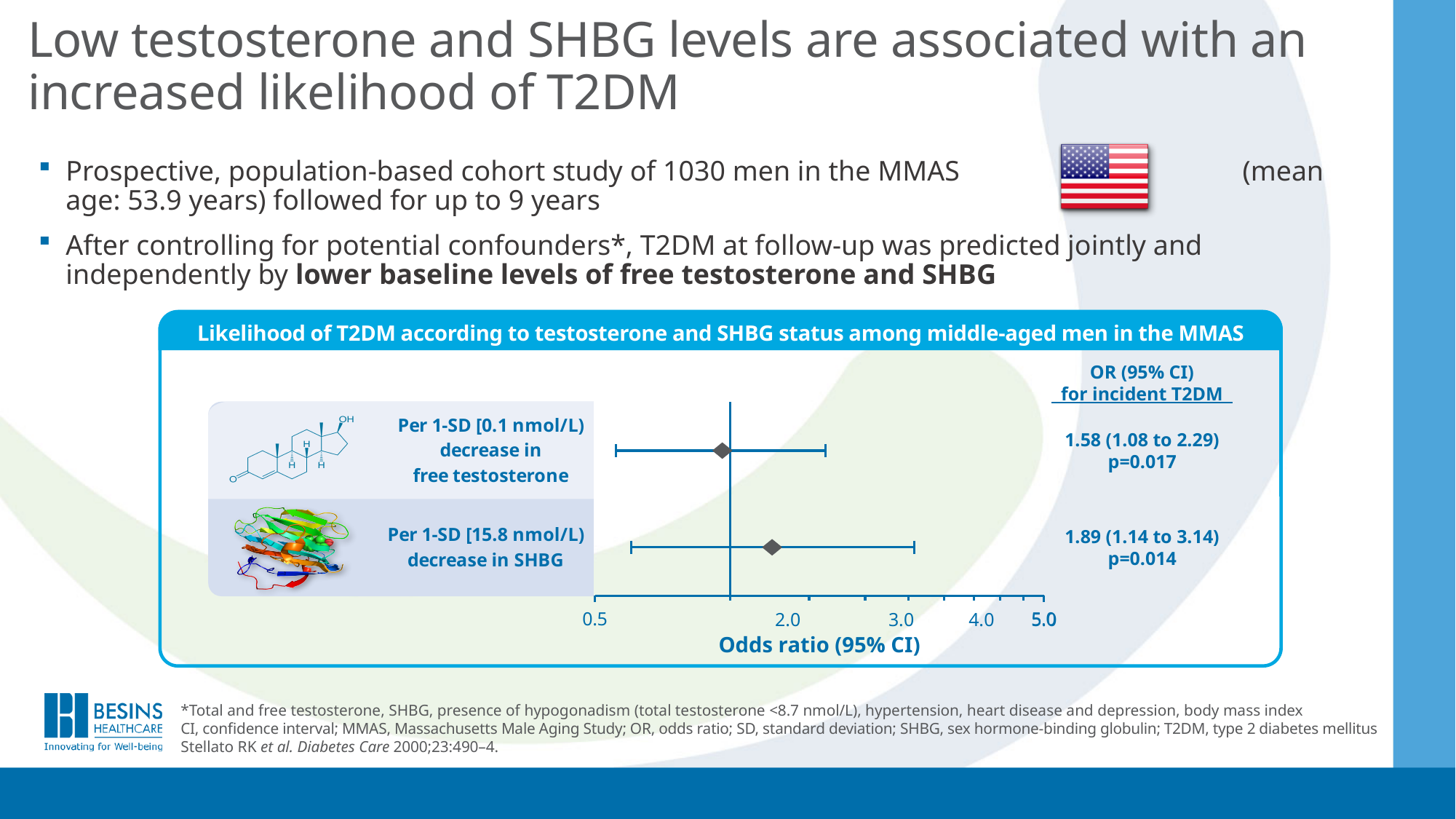
What is the 95% confidence interval for the odds ratio per 1-SD decrease in SHBG? 1.14 to 3.14 What is the difference between the odds ratio for SHBG and the odds ratio for free testosterone? 0.31 What is the p-value for the odds ratio per 1-SD decrease in SHBG? p=0.014 What is the odds ratio for incident T2DM per 1-SD decrease in SHBG? 1.89 Which of the two predictors has the lower odds ratio for incident T2DM? Per 1-SD decrease in free testosterone How many predictors (rows) are plotted in the chart? 2 What is the title of the chart? Likelihood of T2DM according to testosterone and SHBG status among middle-aged men in the MMAS What is the odds ratio for incident T2DM per 1-SD decrease in free testosterone? 1.58 What is the p-value for the odds ratio per 1-SD decrease in free testosterone? p=0.017 Which of the two predictors has the higher odds ratio for incident T2DM? Per 1-SD decrease in SHBG Is the odds ratio for a 1-SD decrease in SHBG greater or less than 2.0? less What is the 95% confidence interval for the odds ratio per 1-SD decrease in free testosterone? 1.08 to 2.29